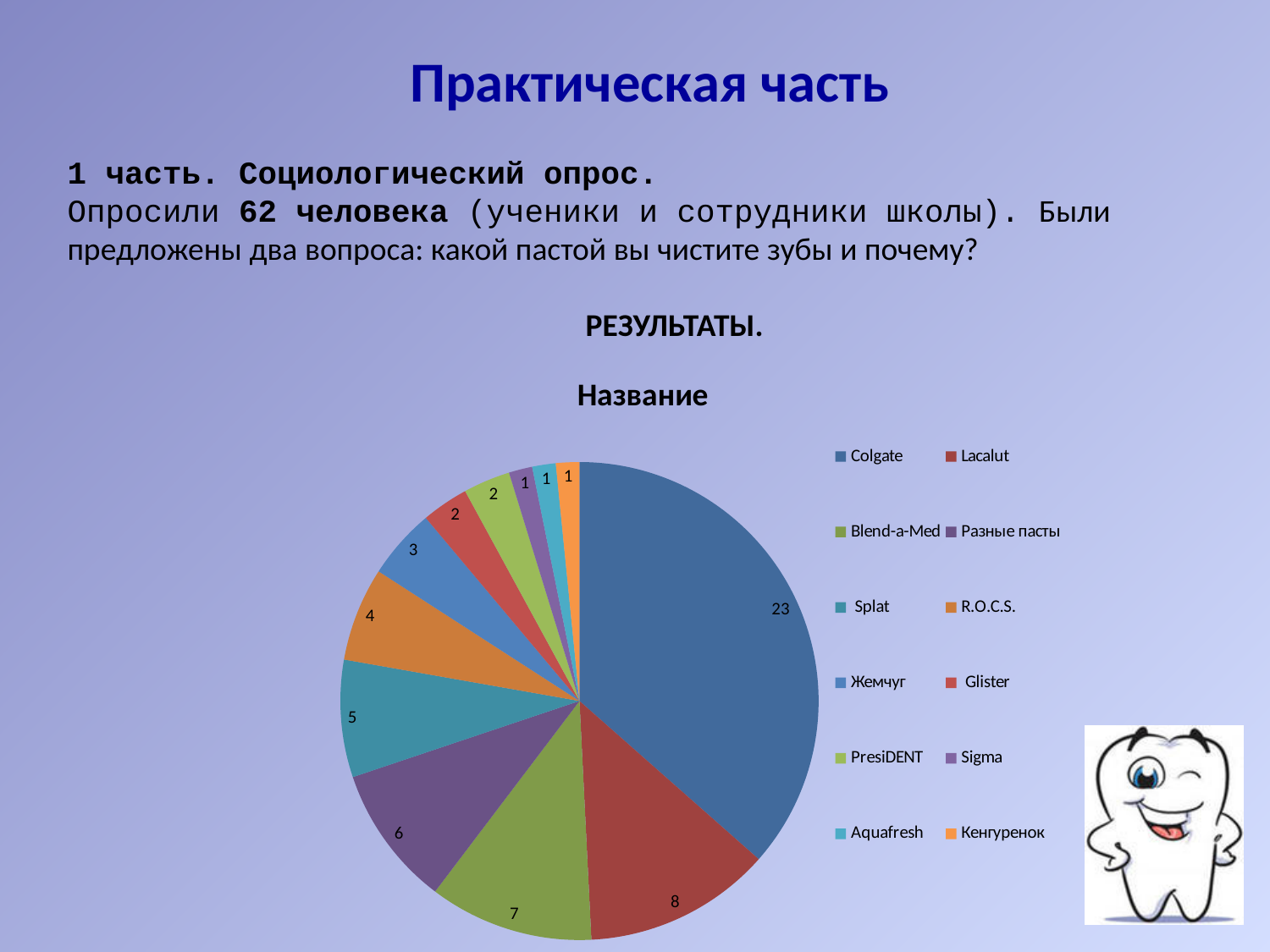
Which toothpaste has the largest slice of the pie? Colgate How many slices does the pie chart have? 12 What kind of chart is shown on the slide? pie chart What is the value for Colgate? 23 What is the value for Splat? 5 What is the difference between the values for Colgate and Lacalut? 15 How many entries does the chart legend list? 12 What is the value for Blend-a-Med? 7 What is the value for Lacalut? 8 What is the title of the chart? Название Which is larger, the value for Разные пасты or the value for R.O.C.S.? Разные пасты What is the difference between the values for Blend-a-Med and Жемчуг? 4